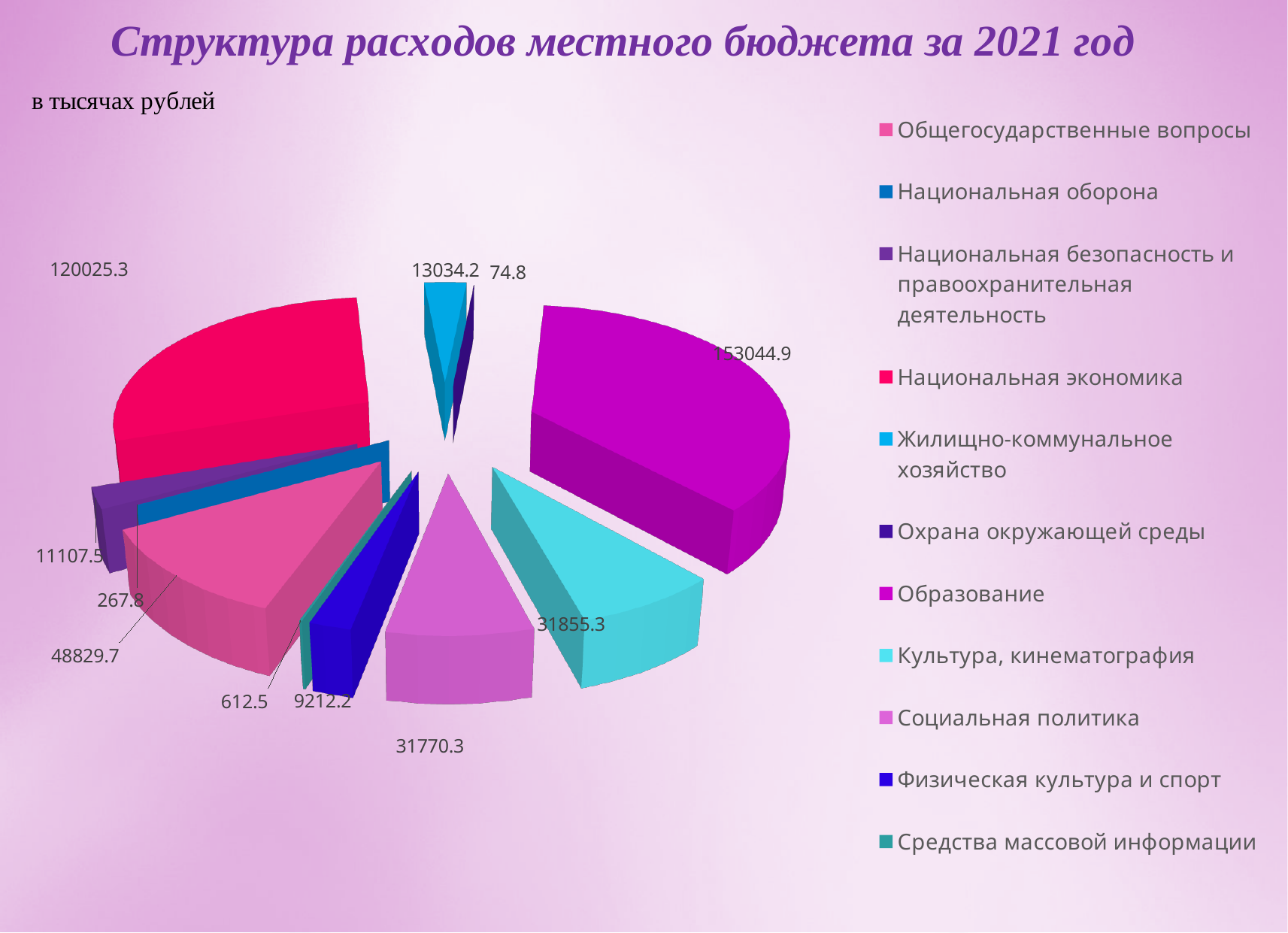
What is the value for Национальная экономика? 120025.3 What is the difference between the values for Образование and Национальная экономика? 33019.6 How many categories does the legend list? 11 Which category has the smallest value? Охрана окружающей среды What is the value for Жилищно-коммунальное хозяйство? 13034.2 What is the value for Общегосударственные вопросы? 48829.7 Which is larger, the value for Культура, кинематография or the value for Социальная политика? Культура, кинематография What is the value for Образование? 153044.9 What is the value for Физическая культура и спорт? 9212.2 Which category has the largest slice of the pie? Образование What kind of chart is shown on the slide? Pie chart What is the title of the chart? Структура расходов местного бюджета за 2021 год